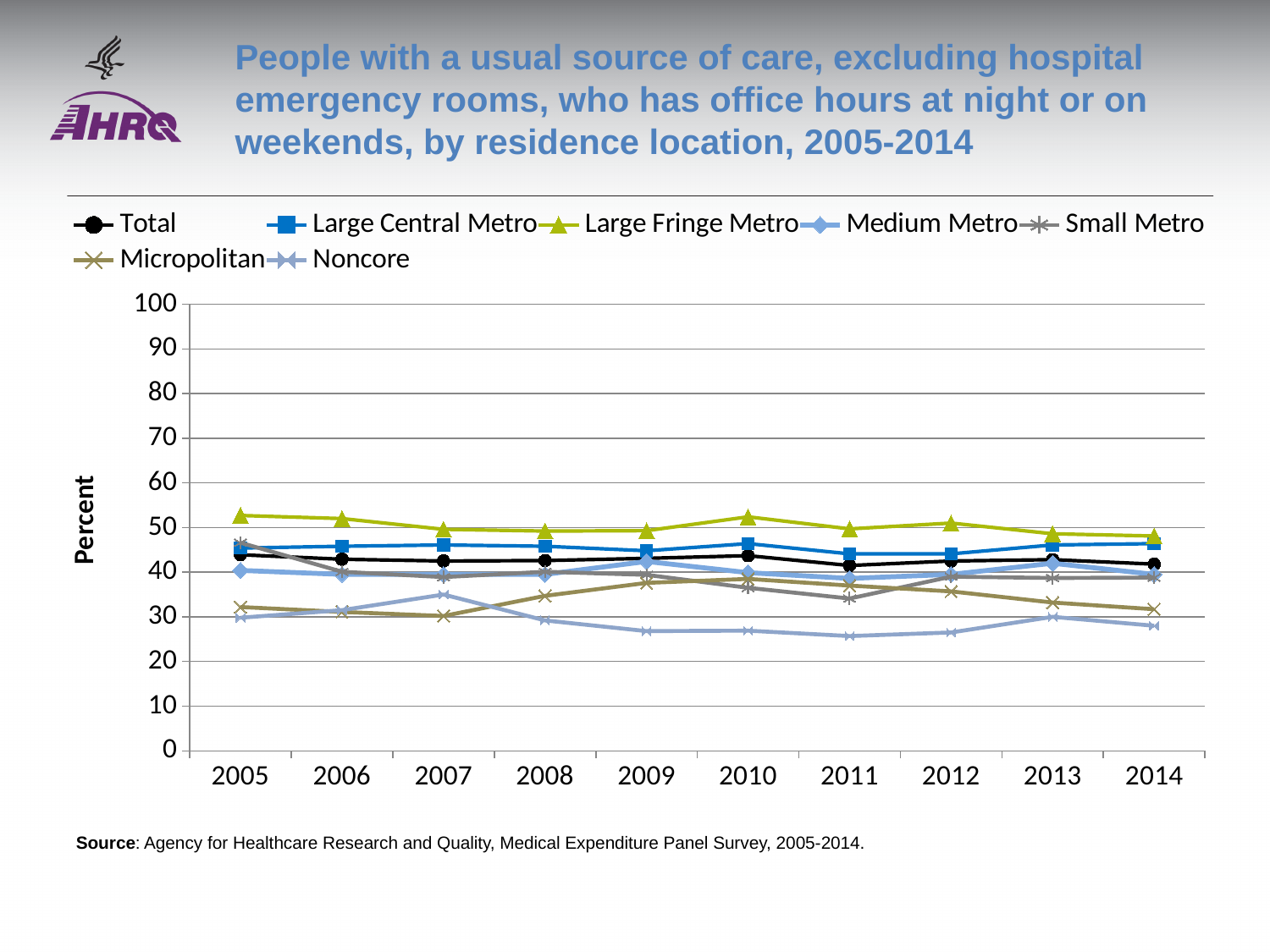
How many series does the legend list? 7 Does the Large Fringe Metro line rise or fall from 2005 to 2014? fall Which series has the lowest value in 2010? Noncore What kind of chart is shown on the slide? line chart Is the value for Large Fringe Metro in 2005 greater or less than 50? greater Is the value for Noncore in 2011 greater or less than 30? less Which series has the highest value in 2005? Large Fringe Metro In 2014, which is larger: the value for Large Fringe Metro or the value for Noncore? Large Fringe Metro Is the value for Total in 2005 greater or less than 40? greater What is the label on the y axis? Percent In 2009, which is larger: the value for Micropolitan or the value for Noncore? Micropolitan How many years are shown on the x axis? 10